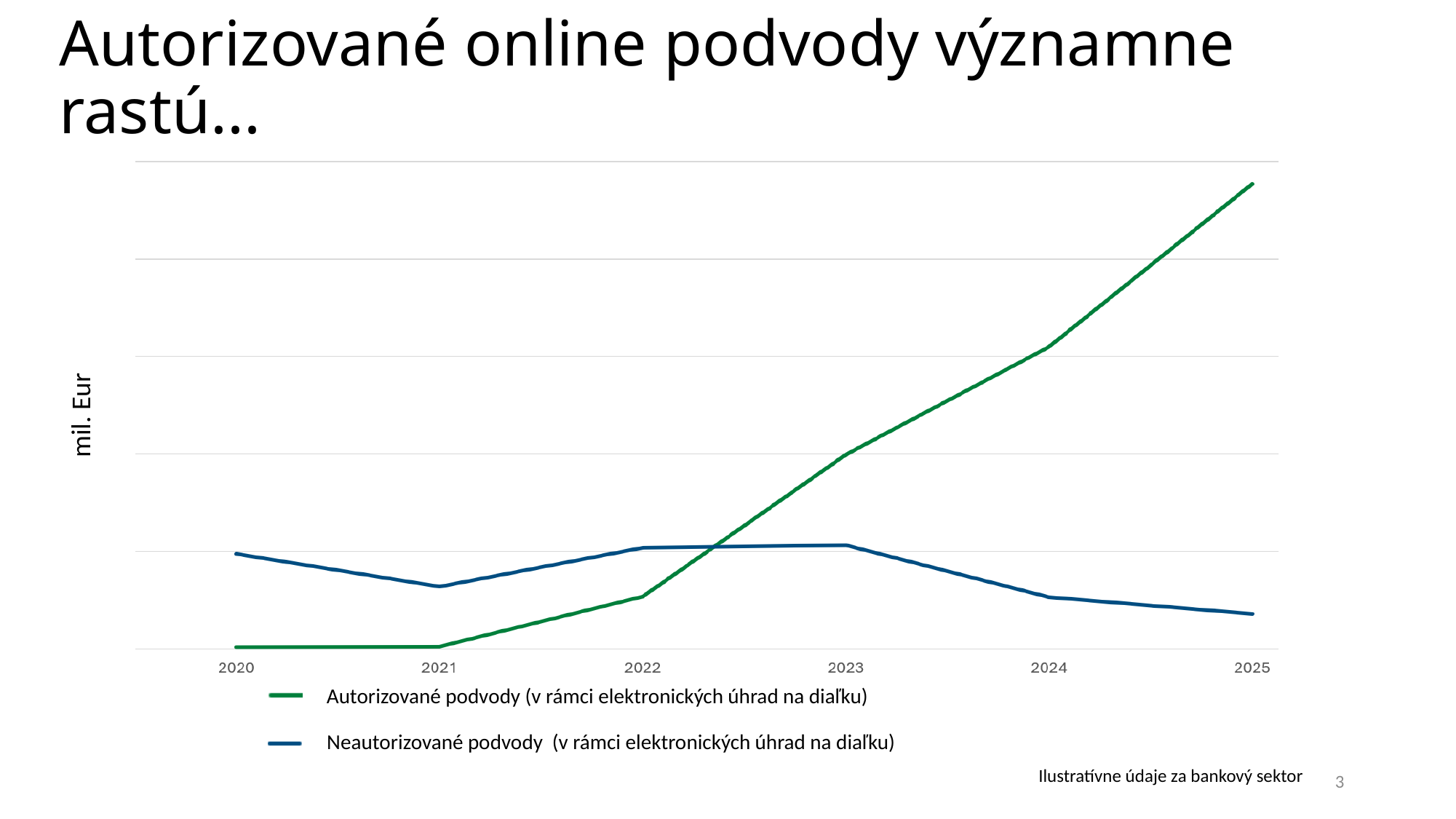
How many years are shown on the x axis? 6 In which year is the Autorizované podvody series at its highest? 2025 What unit is shown on the y axis label? mil. Eur In which year is the Neautorizované podvody series at its lowest? 2025 Does the Autorizované podvody series rise or fall from 2021 to 2025? rise In 2020, which series has the higher value, Autorizované podvody or Neautorizované podvody? Neautorizované podvody What kind of chart is shown on the slide? line chart How many series does the legend list? 2 What is the first year shown on the x axis? 2020 In 2025, which series has the higher value, Autorizované podvody or Neautorizované podvody? Autorizované podvody Does the Neautorizované podvody series rise or fall from 2023 to 2025? fall What is the last year shown on the x axis? 2025